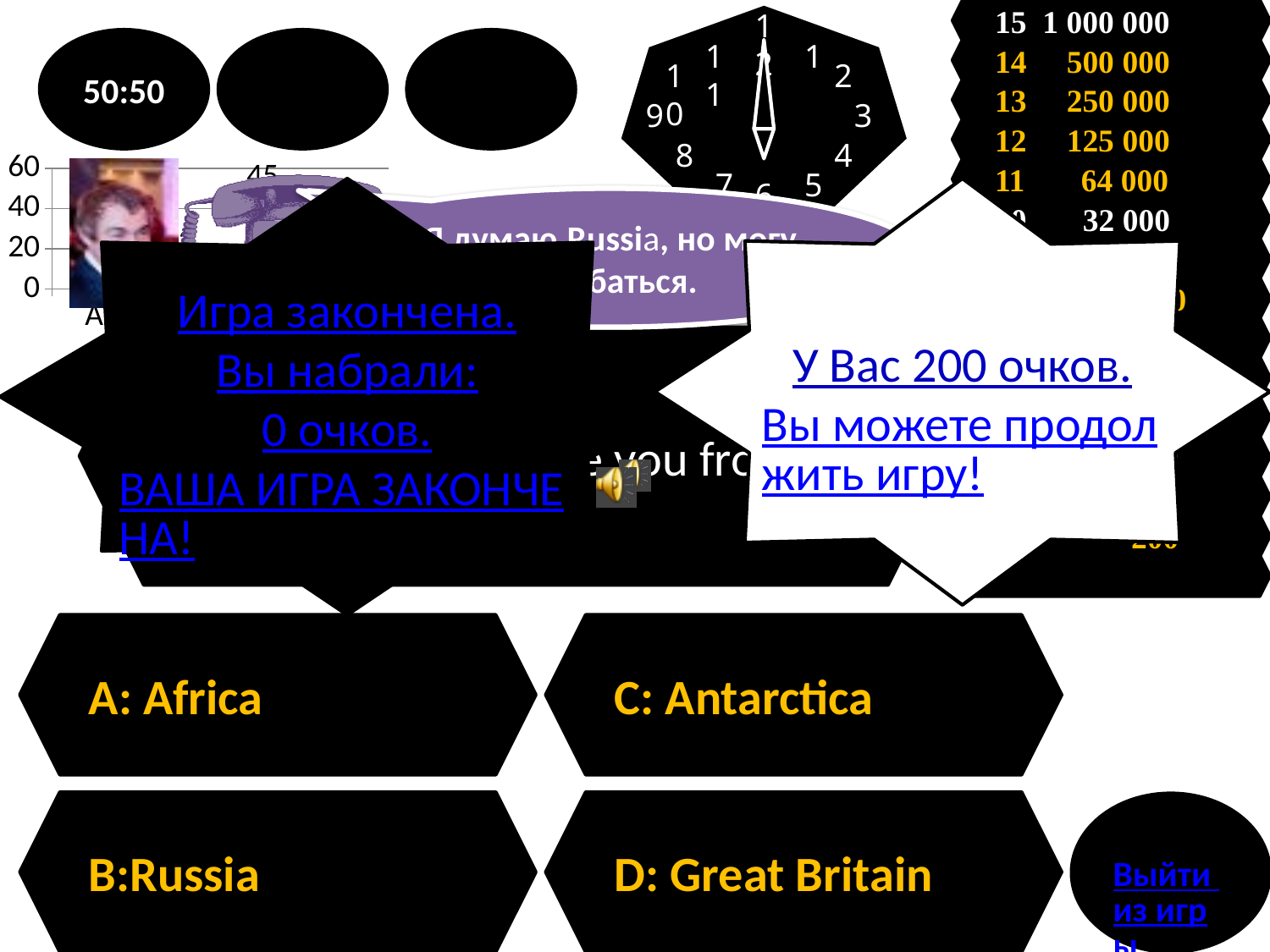
What is the lowest value shown on the vertical axis of the chart in the top-left corner of the slide? 0 What is the interval between consecutive tick marks on the vertical axis of the chart in the top-left corner of the slide? 20 What is the highest value shown on the vertical axis of the chart in the top-left corner of the slide? 60 What data label value is printed near the top of the chart in the top-left corner of the slide? 45